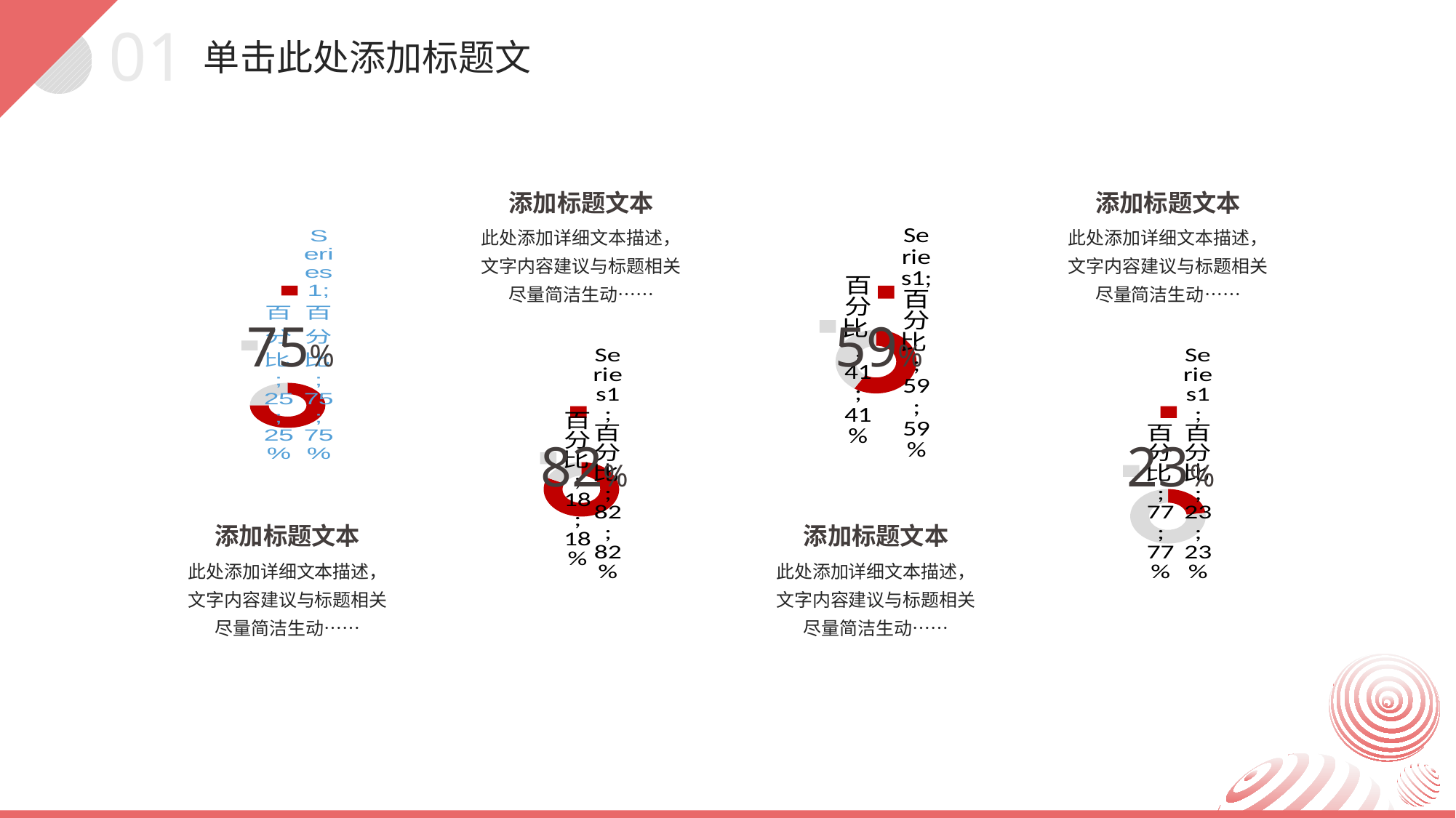
Which of the four doughnut charts shows the lowest central percentage value? the rightmost (23%) What large percentage value is displayed in the centre of the second doughnut chart from the left? 82% What kind of chart is the leftmost chart on the slide? doughnut chart What large percentage value is displayed in the centre of the third doughnut chart from the left? 59% What large percentage value is displayed in the centre of the rightmost doughnut chart? 23% In the leftmost doughnut chart, what percentage does the grey slice represent according to its data label? 25% What is the difference between the central values of the second doughnut chart from the left and the leftmost doughnut chart? 7% Which of the four doughnut charts shows the highest central percentage value? the second from the left (82%) In the rightmost doughnut chart, what percentage does the grey slice represent according to its data label? 77% How many slices does each doughnut chart on the slide have? 2 Is the central value of the third doughnut chart from the left larger or smaller than the central value of the rightmost doughnut chart? larger What large percentage value is displayed in the centre of the leftmost doughnut chart? 75%